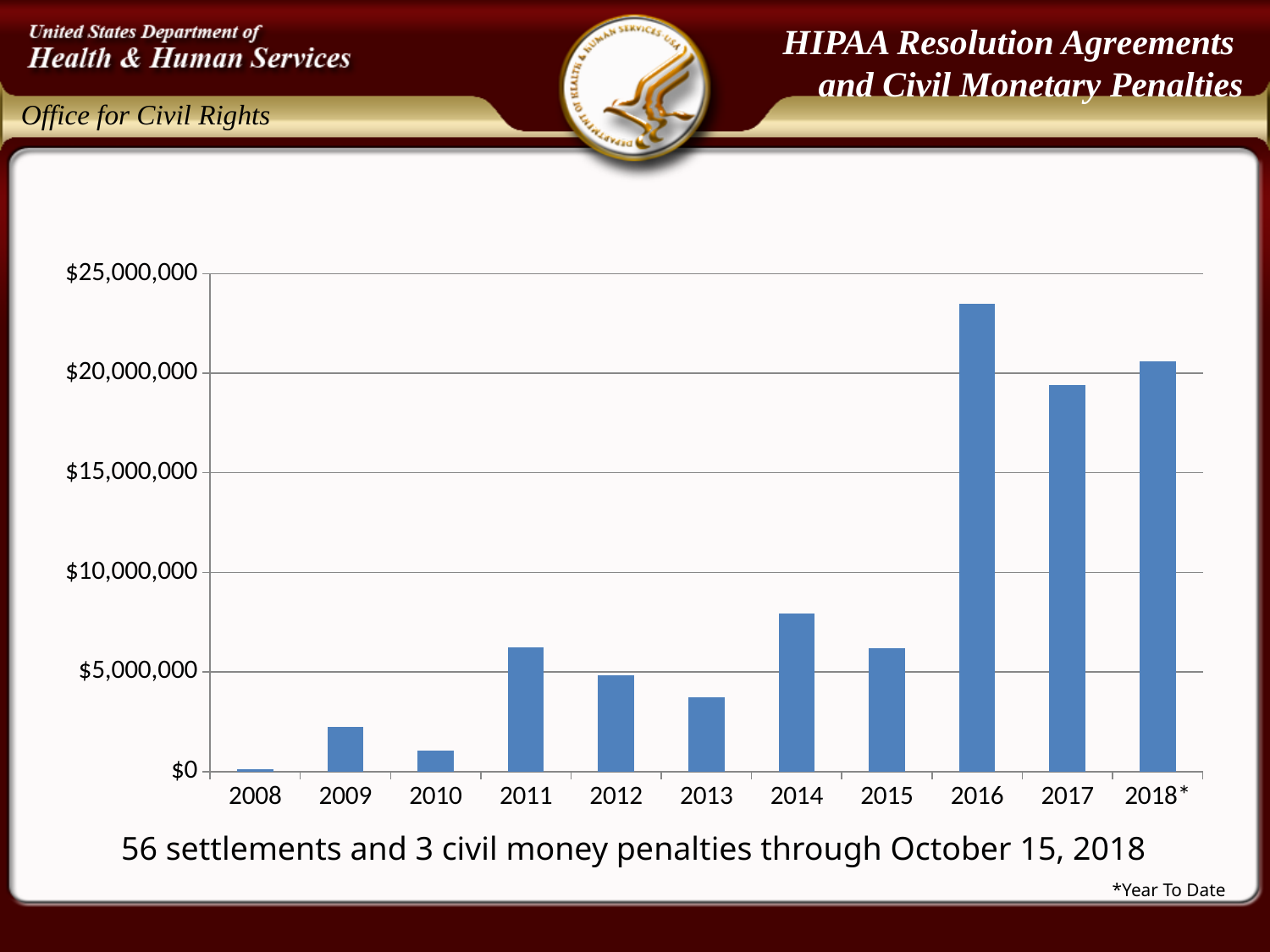
What kind of chart is shown on the slide? bar chart What does the asterisk next to 2018 on the x axis indicate, according to the footnote? Year To Date Is the value for 2016 greater or less than $20,000,000? greater Is the value for 2009 greater or less than $5,000,000? less Which year has the lowest bar in the chart? 2008 Is the value for 2017 greater or less than $20,000,000? less How many years are shown on the x axis of the chart? 11 Which year has the highest bar in the chart? 2016 Which year has the larger value, 2013 or 2014? 2014 Which year has the larger value, 2016 or 2017? 2016